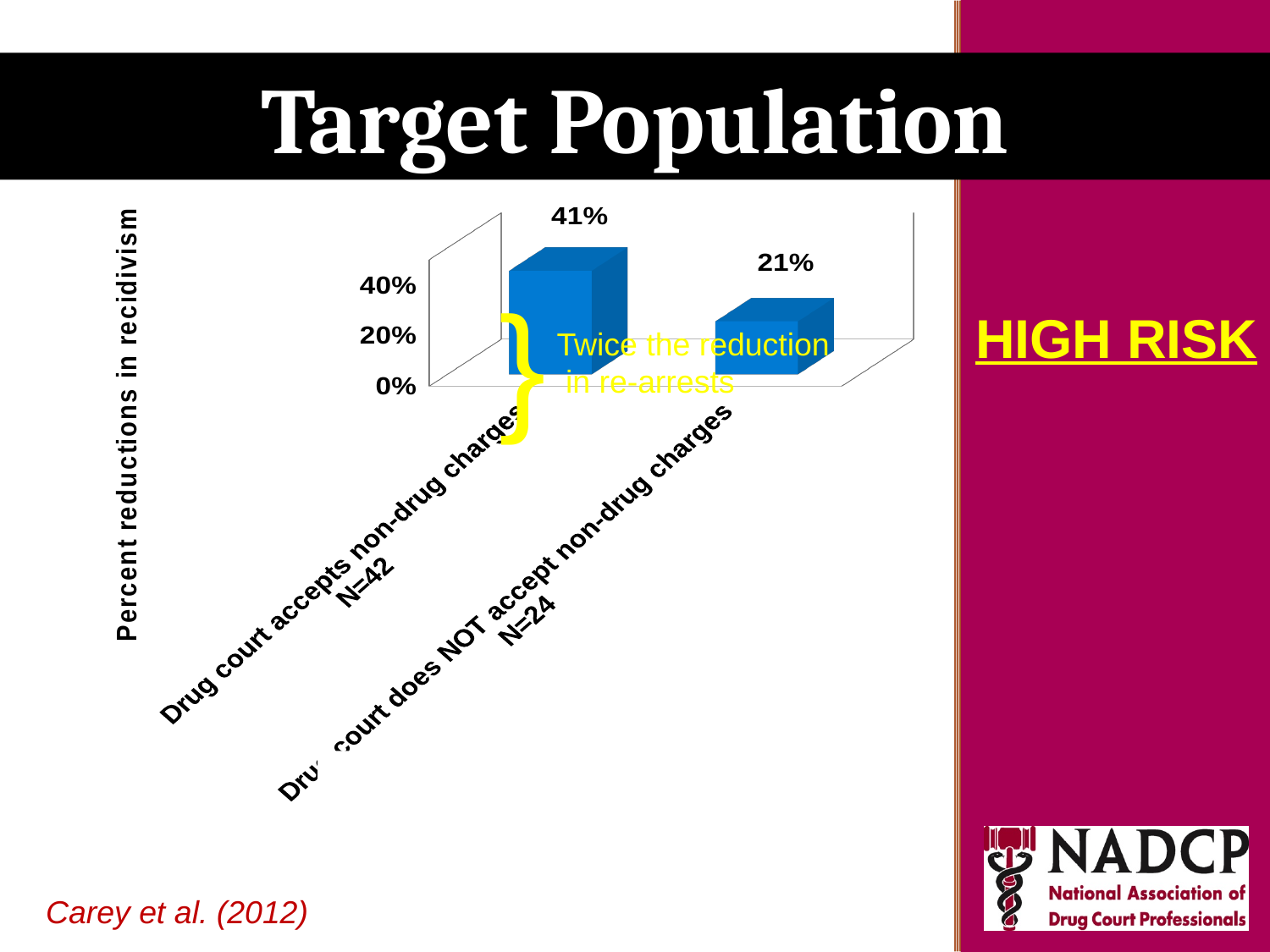
Is the value for drug courts that do NOT accept non-drug charges greater or less than 40%? less Which category shows the lower percent reduction in recidivism? Drug court does NOT accept non-drug charges N=24 Is the value for drug courts that accept non-drug charges greater or less than 40%? greater What is the percent reduction in recidivism for drug courts that do NOT accept non-drug charges (N=24)? 21% Which category shows the higher percent reduction in recidivism? Drug court accepts non-drug charges N=42 How many categories are plotted in the chart? 2 What is the sample size (N) for the drug courts that do NOT accept non-drug charges? N=24 What is the percent reduction in recidivism for drug courts that accept non-drug charges (N=42)? 41% What is the difference in percent reduction in recidivism between drug courts that accept non-drug charges and those that do not? 20% What is the label of the vertical axis of the chart? Percent reductions in recidivism Is the percent reduction in recidivism larger for drug courts that accept non-drug charges or for those that do NOT accept non-drug charges? Drug court accepts non-drug charges What kind of chart is shown on the slide? Bar chart